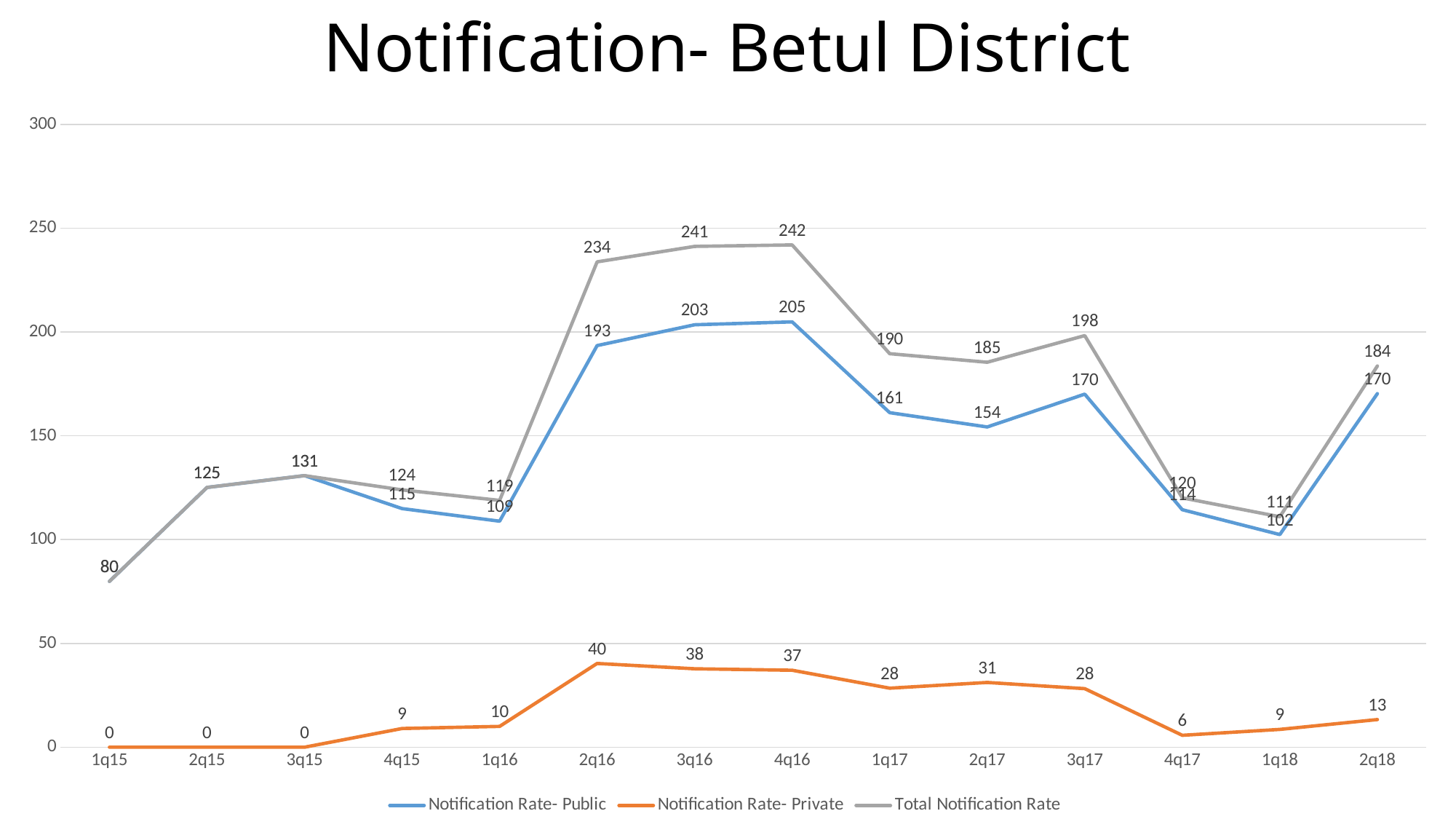
Which quarter has the higher Notification Rate- Public, 1q17 or 2q17? 1q17 What is the Total Notification Rate for 4q16? 242 What is the Notification Rate- Public for 3q16? 203 In which quarter is the Total Notification Rate highest? 4q16 What is the difference between the Total Notification Rate and the Notification Rate- Public in 2q18? 14 What is the title of the chart? Notification- Betul District How many quarters are plotted along the x axis? 14 What kind of chart is shown on the slide? line chart What is the Notification Rate- Private for 2q16? 40 In which quarter is the Notification Rate- Private highest? 2q16 In which quarter is the Total Notification Rate lowest? 1q15 How many series does the legend list? 3